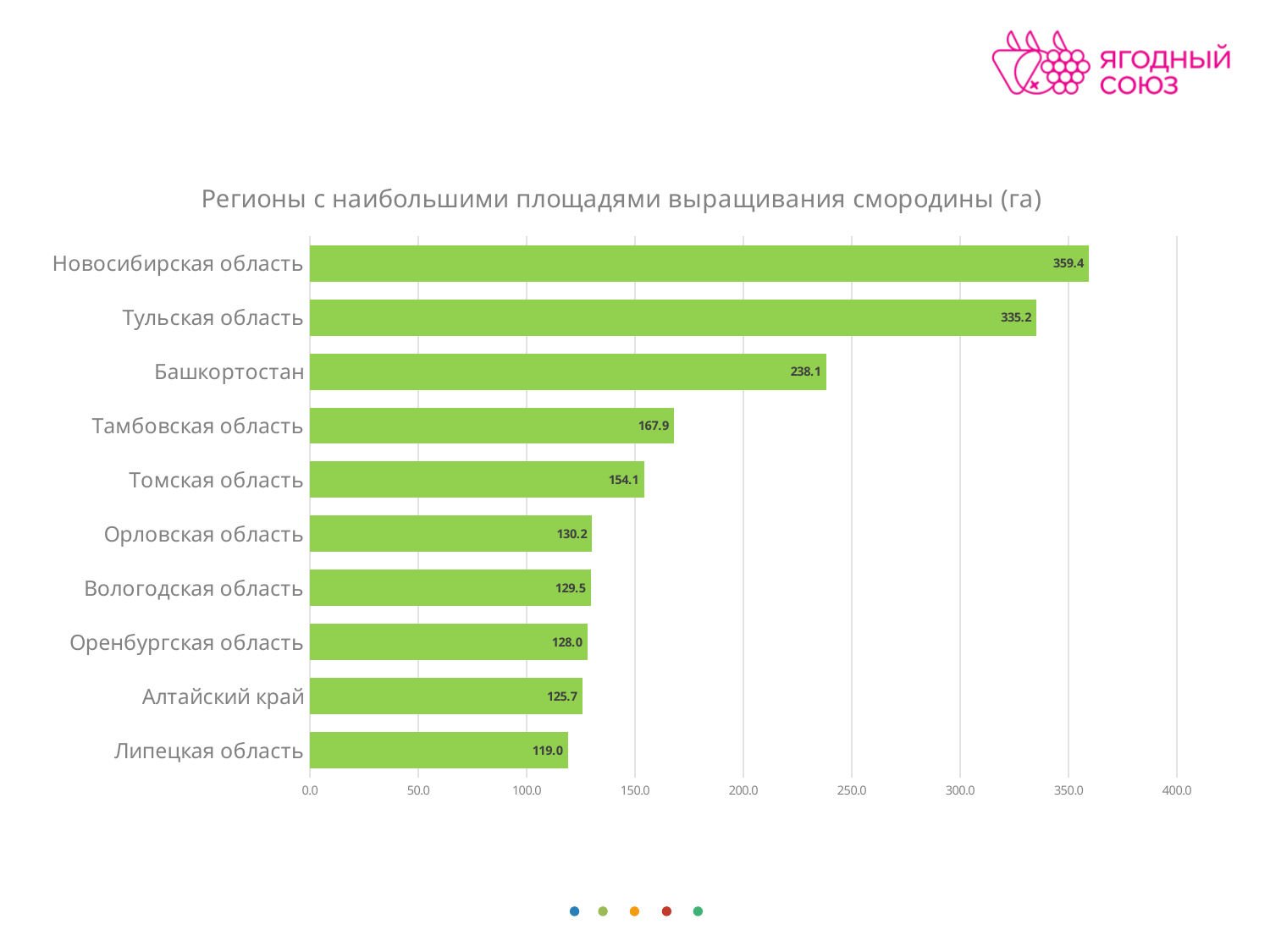
What is the value for Башкортостан? 238.1 Which is larger, the value for Тамбовская область or the value for Орловская область? Тамбовская область What is the difference between the values for Новосибирская область and Тульская область? 24.2 What kind of chart is shown on the slide? bar chart How many regions are shown in the chart? 10 What is the value for Новосибирская область? 359.4 What is the value for Липецкая область? 119.0 Which region has the highest value? Новосибирская область What is the title of the chart? Регионы с наибольшими площадями выращивания смородины (га) Is the value for Башкортостан greater or less than 250.0? less Which region has the lowest value? Липецкая область What is the value for Томская область? 154.1